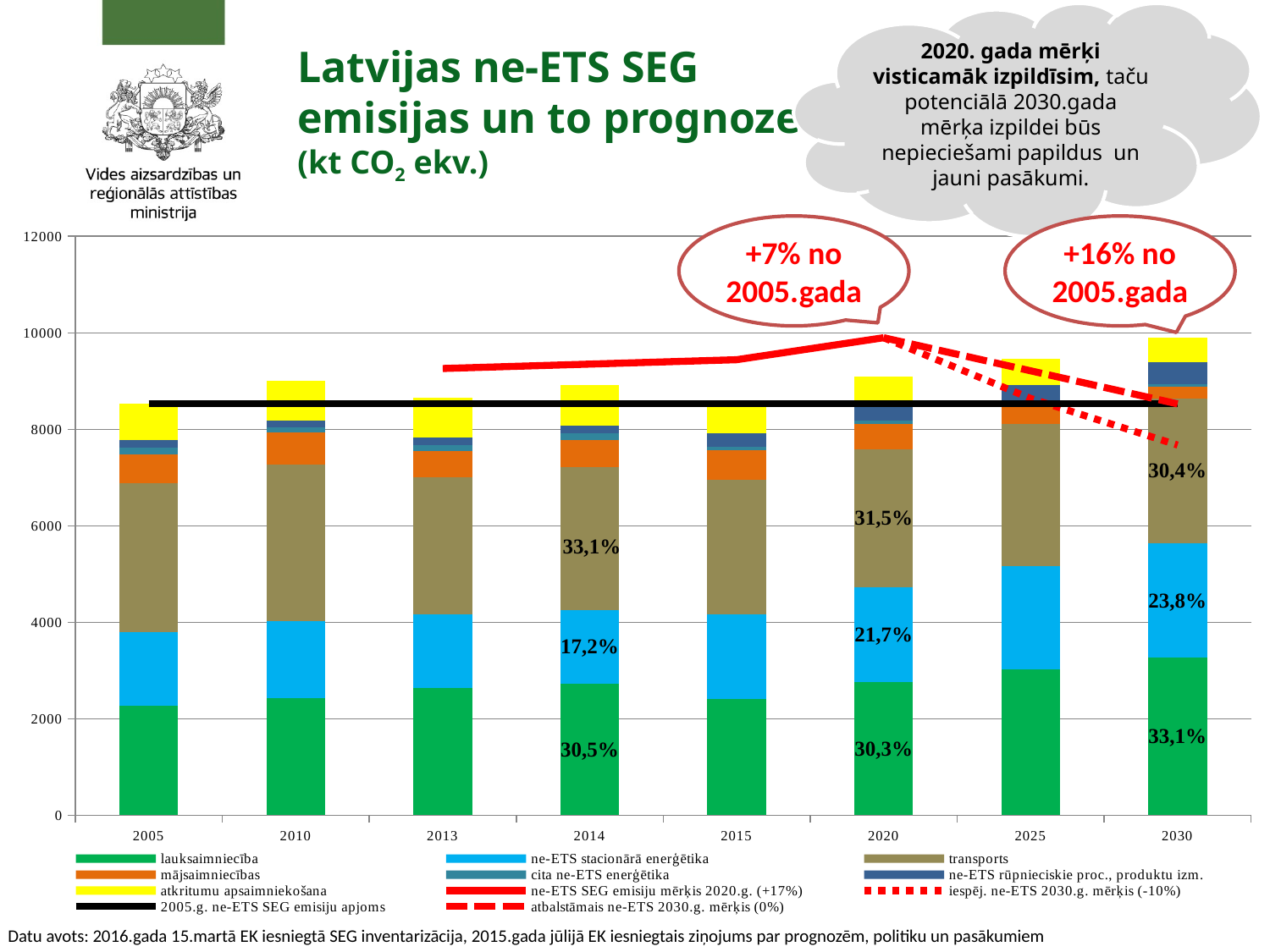
What percentage label is shown for transports in 2030? 30,4% What kind of chart is shown on the slide? Stacked bar chart Is the lauksaimniecība share label larger in 2014 or in 2030? 2030 Which year has the tallest stacked bar? 2030 Is the total height of the 2030 stacked bar greater or less than 8000? greater How many entries does the chart legend list? 11 What does the callout above the 2030 bar say? +16% no 2005.gada Does the lauksaimniecība (green) segment rise or fall from 2005 to 2030? rise What percentage label is shown for ne-ETS stacionārā enerģētika in 2020? 21,7% By how many percentage points does the ne-ETS stacionārā enerģētika label in 2030 exceed the one in 2014? 6,6 What percentage label is shown for lauksaimniecība in 2014? 30,5% How many years are shown on the x axis of the chart? 8